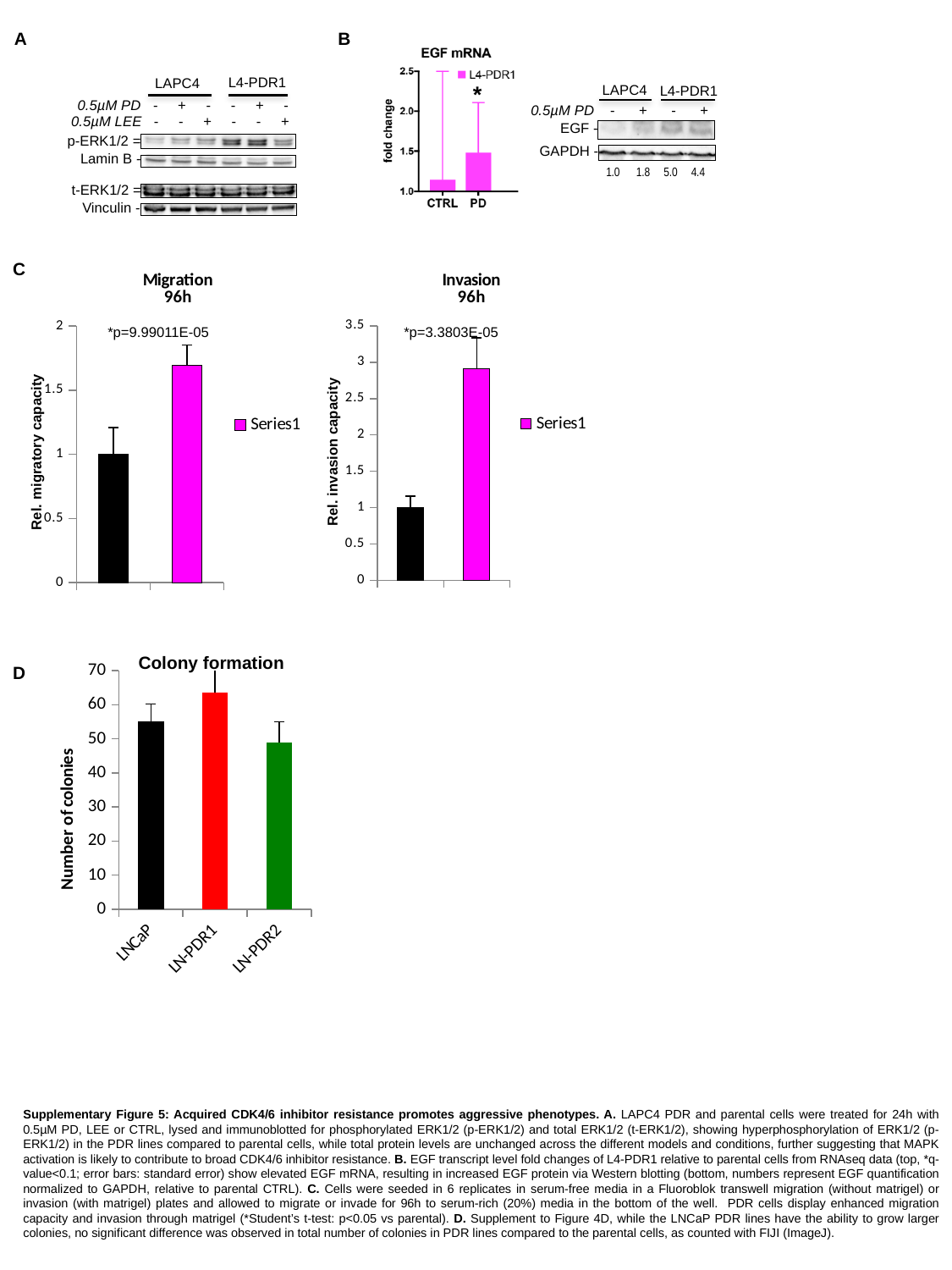
In the Colony formation chart, which has more colonies, LNCaP or LN-PDR2? LNCaP How many categories are shown on the x axis of the Colony formation chart? 3 In the EGF mRNA chart, which bar is higher, CTRL or PD? PD How many series does the legend of the Migration 96h chart list? 1 What kind of chart is the Colony formation chart? bar chart In the Invasion 96h chart, is the value of the magenta (second) bar greater or less than 2.5? greater What p-value is printed on the Invasion 96h chart? *p=3.3803E-05 In the Colony formation chart, which cell line has the lowest number of colonies? LN-PDR2 What p-value is printed on the Migration 96h chart? *p=9.99011E-05 In the Colony formation chart, is the value for LNCaP greater or less than 50? greater In the Colony formation chart, is the value for LN-PDR1 greater or less than 60? greater In the Colony formation chart, which cell line has the highest number of colonies? LN-PDR1